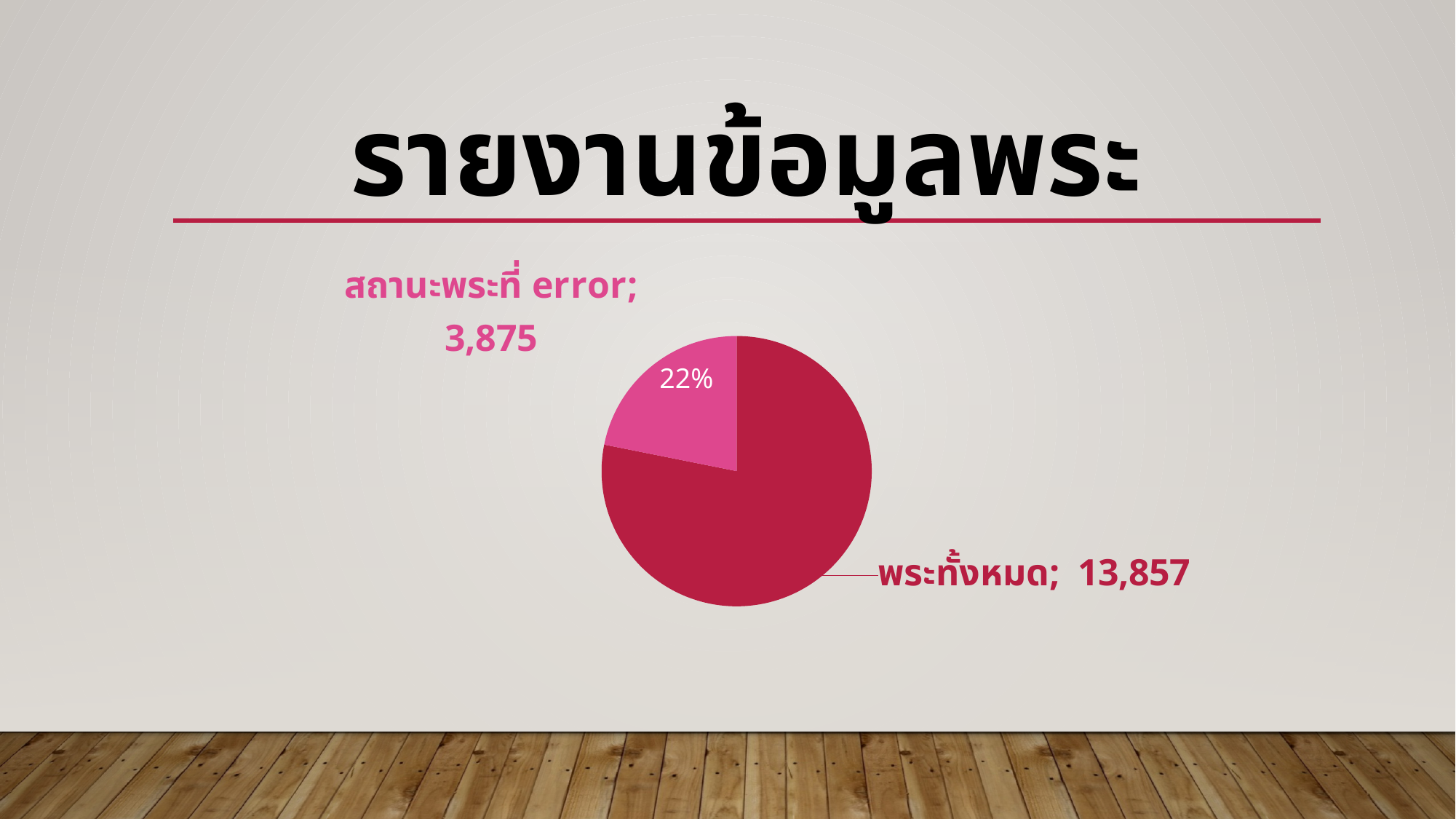
Which slice of the pie chart is the smallest? สถานะพระที่ error What is the total of the two values shown in the pie chart? 17,732 Which slice of the pie chart is shown in the lighter pink colour? สถานะพระที่ error What kind of chart is shown on the slide? pie chart What percentage share of the pie does the สถานะพระที่ error slice represent? 22% Which slice of the pie chart is the largest? พระทั้งหมด How many slices does the pie chart have? 2 What is the value for พระทั้งหมด in the pie chart? 13,857 Which is larger, the value for พระทั้งหมด or the value for สถานะพระที่ error? พระทั้งหมด What is the title of the slide containing the pie chart? รายงานข้อมูลพระ What is the value for สถานะพระที่ error in the pie chart? 3,875 What is the difference between the value for พระทั้งหมด and the value for สถานะพระที่ error? 9,982